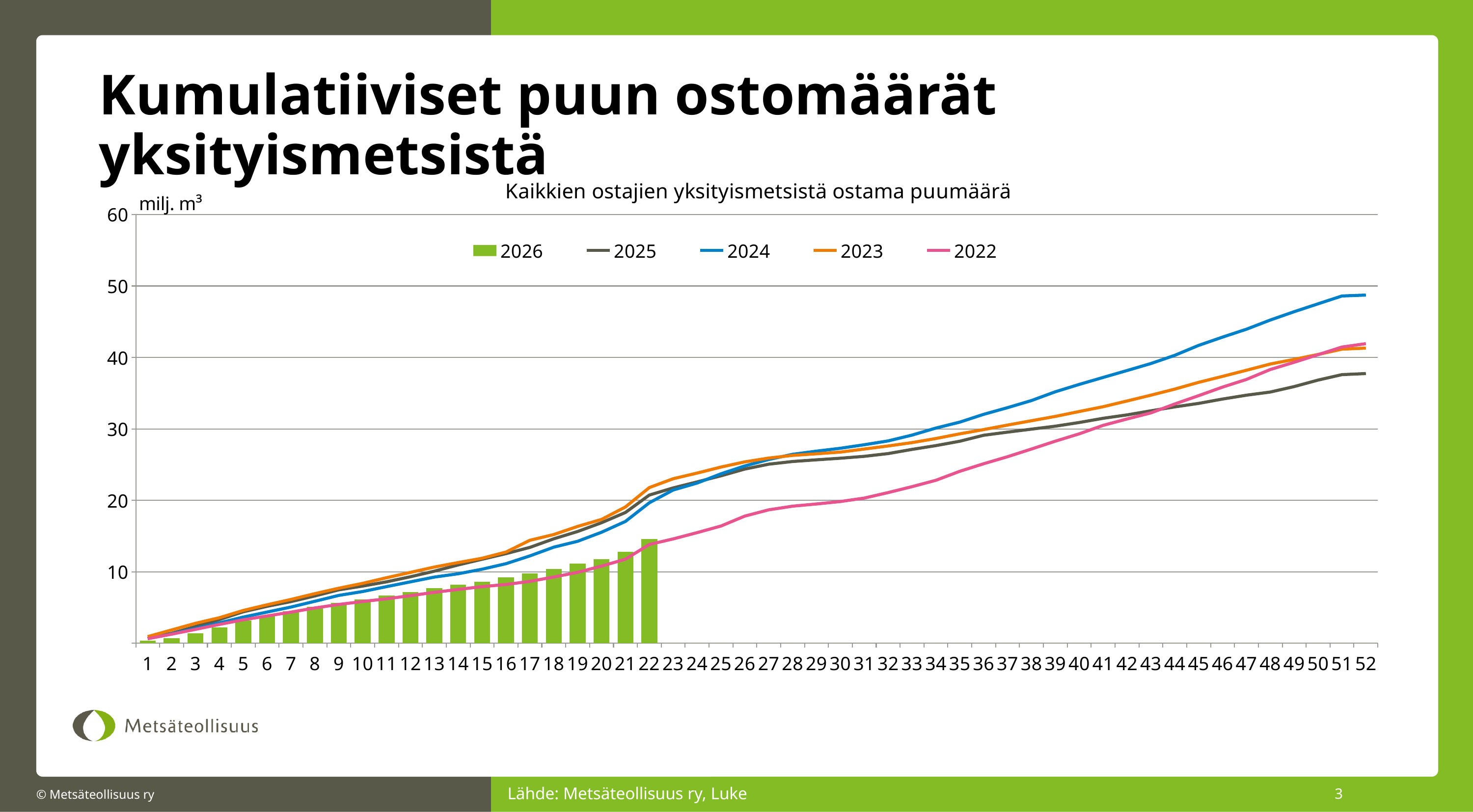
Is the value for 2026 at week 22 greater or less than 10? greater At week 30, which is larger: the value for 2025 or the value for 2022? 2025 How many series does the legend list? 5 Which series has the highest value at week 52? 2024 Do the line series rise or fall as the week number increases? rise Which series has the lowest value at week 52? 2025 Is the value for 2024 at week 52 greater or less than 40? greater What unit is shown on the y axis of the chart? milj. m³ How many weeks are shown on the x axis? 52 Is the value for 2025 at week 52 greater or less than 40? less Up to which week are bars plotted for the 2026 series? 22 What kind of chart is shown on the slide? A combined bar and line chart